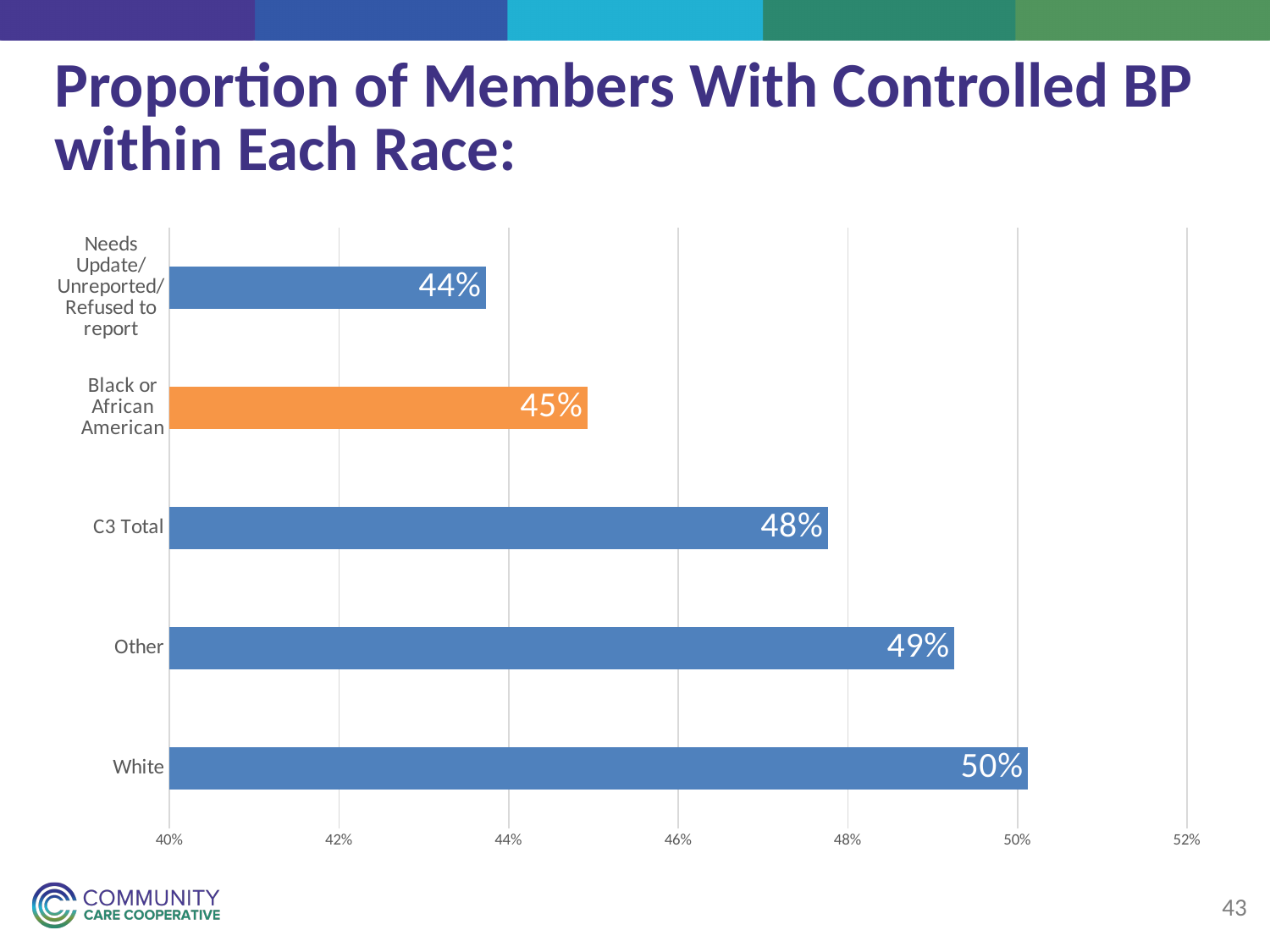
What is the difference in percentage points between White and Black or African American? 5 percentage points What is the value shown for Needs Update/Unreported/Refused to report? 44% What is the value shown for the Other category? 49% How many categories are shown on the chart? 5 What is the value shown for C3 Total? 48% Which category has the lowest proportion of members with controlled BP? Needs Update/Unreported/Refused to report Which is larger, the value for Other or the value for C3 Total? Other What is the proportion of members with controlled BP for White? 50% Which category has the highest proportion of members with controlled BP? White Which category's bar is coloured orange rather than blue? Black or African American What type of chart is shown on the slide? Bar chart What is the proportion of members with controlled BP for Black or African American? 45%